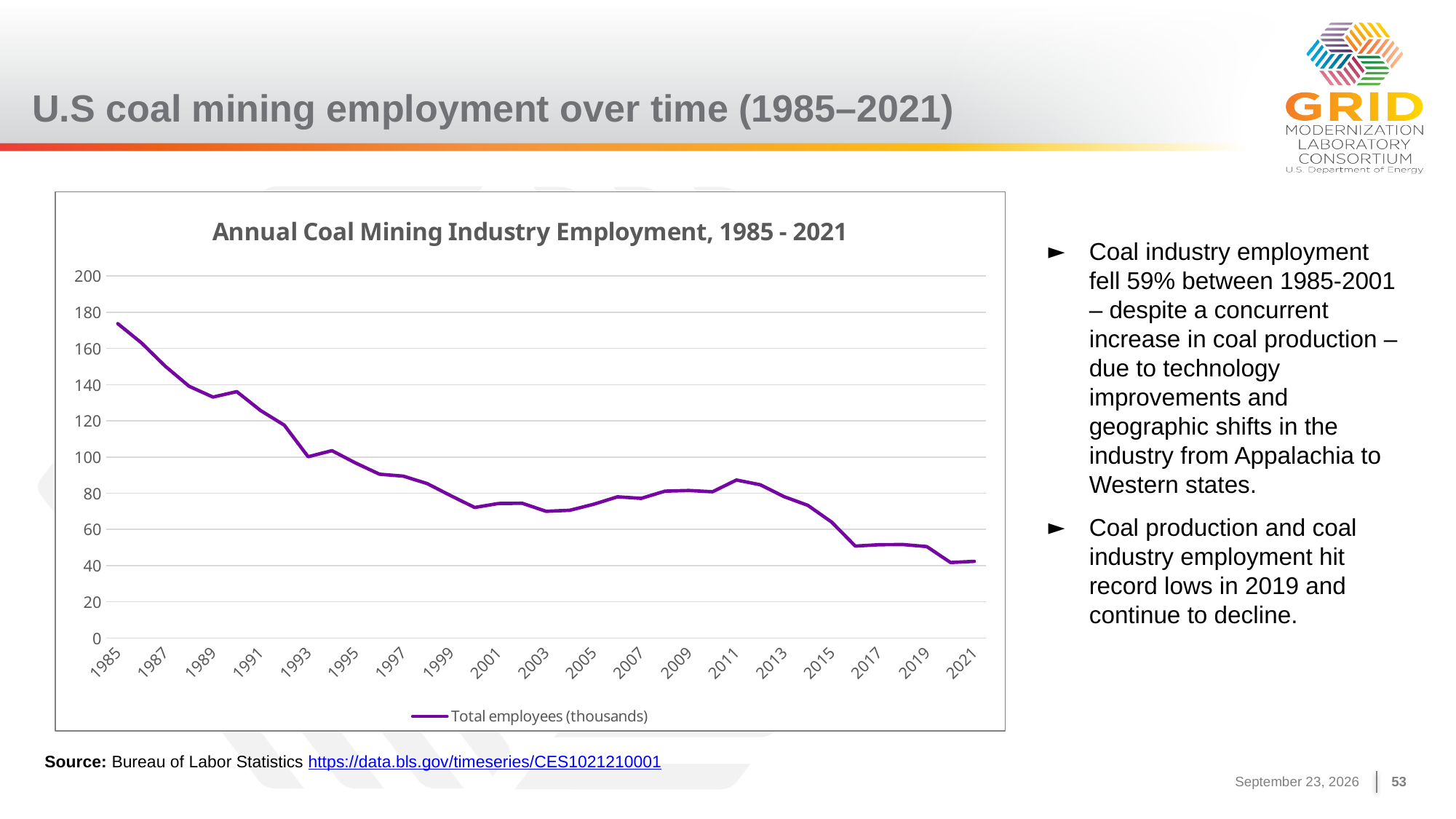
Is the value for 1985 greater or less than 160? greater Overall, do the values rise or fall from 1985 to 2021? Fall Is the value for 2021 greater or less than 60? less What is the name of the series shown in the legend? Total employees (thousands) How many series does the chart legend list? 1 How many year labels are shown on the x axis? 19 What is the title of the chart? Annual Coal Mining Industry Employment, 1985 - 2021 Is the value for 1989 greater or less than 120? greater Which year has the highest value for total employees? 1985 Which year has the larger value, 2001 or 2011? 2011 What kind of chart is shown on the slide? Line chart